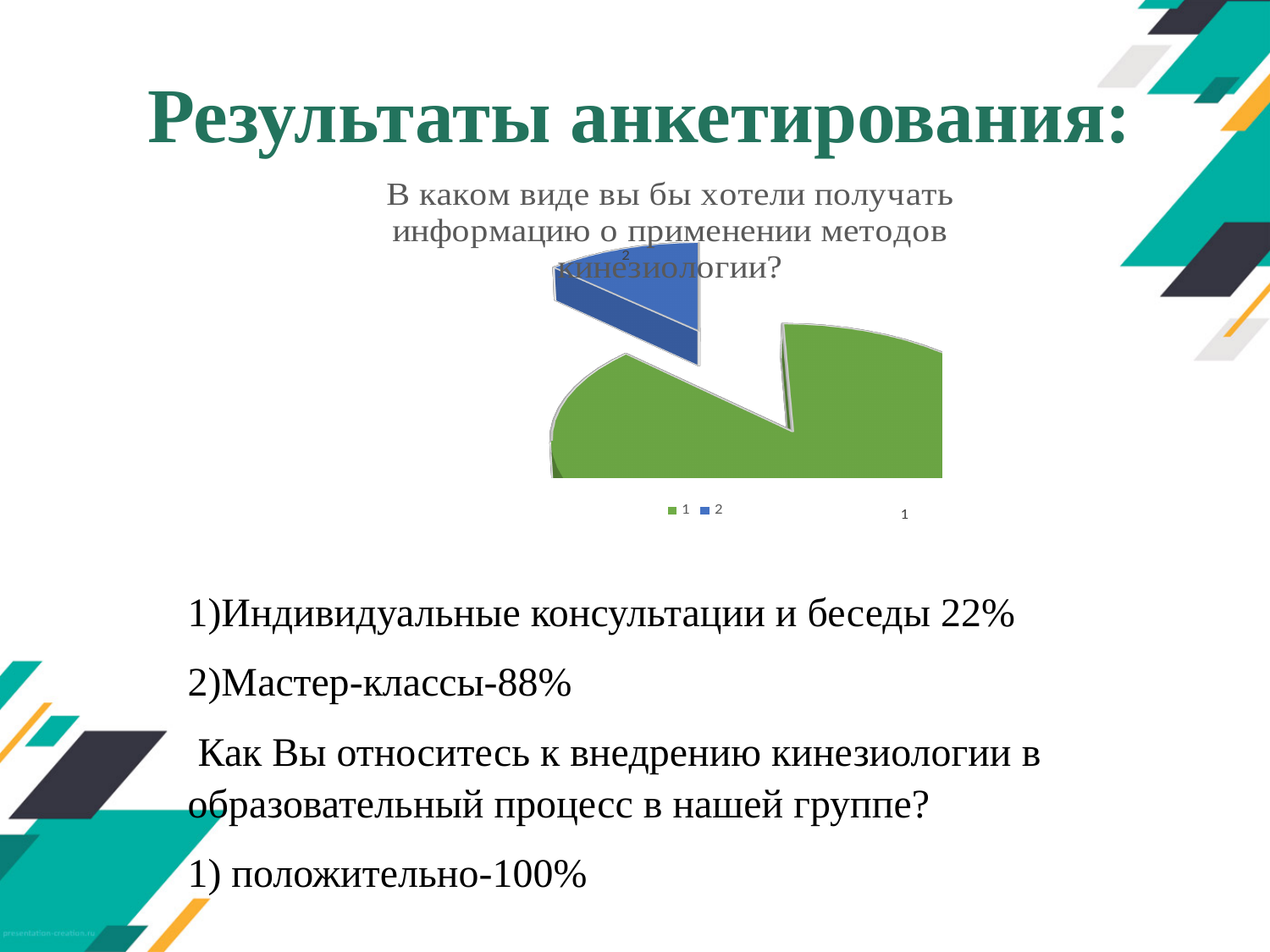
How many slices does the pie chart have? 2 Which category has the largest slice in the pie chart? 1 Which slice of the pie chart is larger, slice 1 or slice 2? 1 What colour is the slice labelled 1 in the pie chart? green Which category has the smallest slice in the pie chart? 2 What colour is the slice labelled 2 in the pie chart? blue How many entries does the legend of the pie chart list? 2 What kind of chart is shown on the slide? pie chart